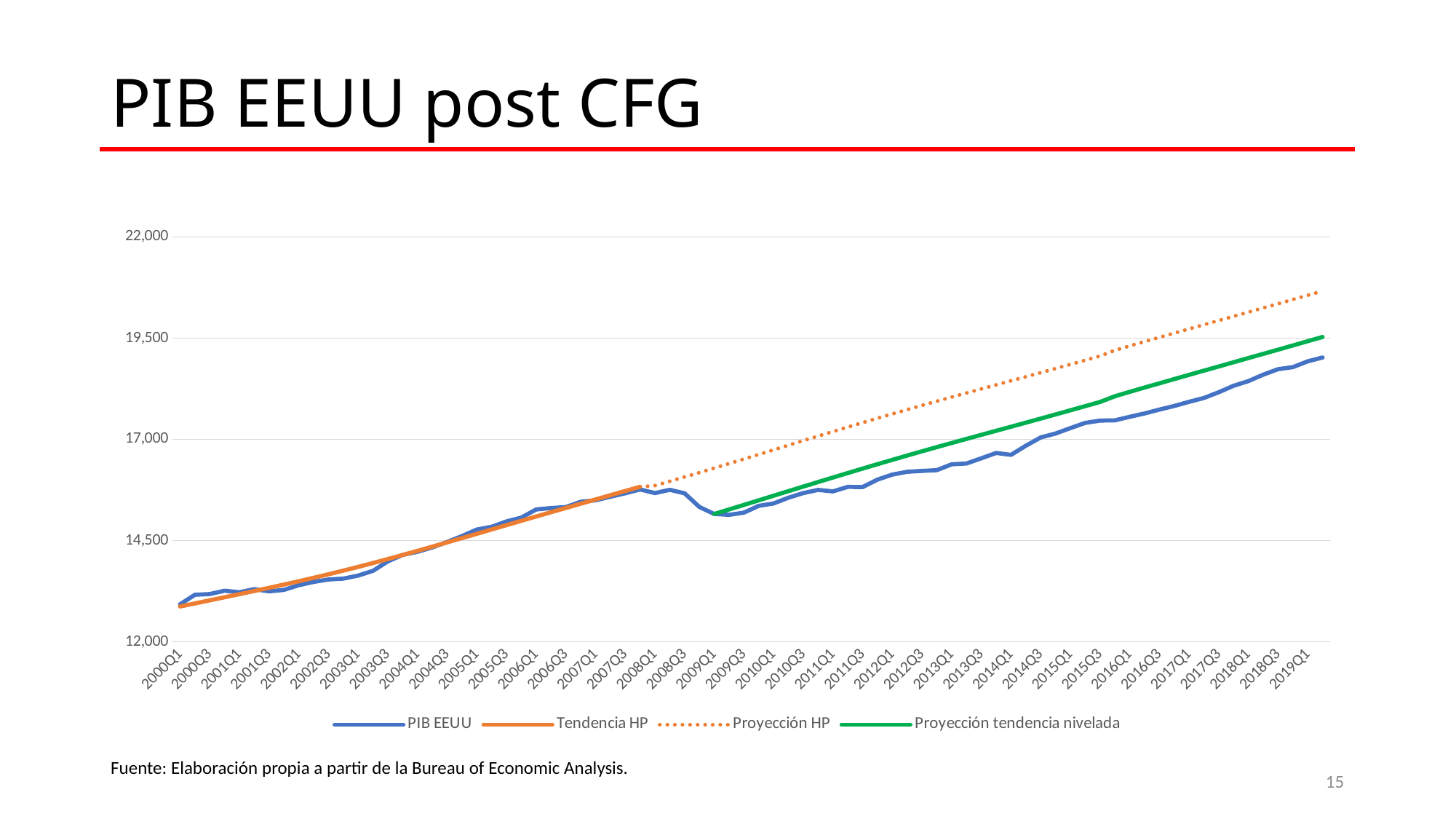
Does the PIB EEUU series rise or fall overall from 2000Q1 to 2019Q1? rise At 2019Q1, which is higher: Proyección HP or PIB EEUU? Proyección HP Which series in the legend is drawn as a dotted line? Proyección HP Does the PIB EEUU series rise or fall between 2008Q1 and 2009Q1? fall Is the value of PIB EEUU at 2000Q1 greater or less than 12,000? greater What kind of chart is shown on the slide? line chart Is the value of Proyección HP at 2019Q1 greater or less than 19,500? greater Is the value of PIB EEUU at 2009Q1 greater or less than 17,000? less Which series reaches the highest value at the right end of the chart (2019Q1)? Proyección HP What is the title of the slide containing the chart? PIB EEUU post CFG How many series does the legend list? 4